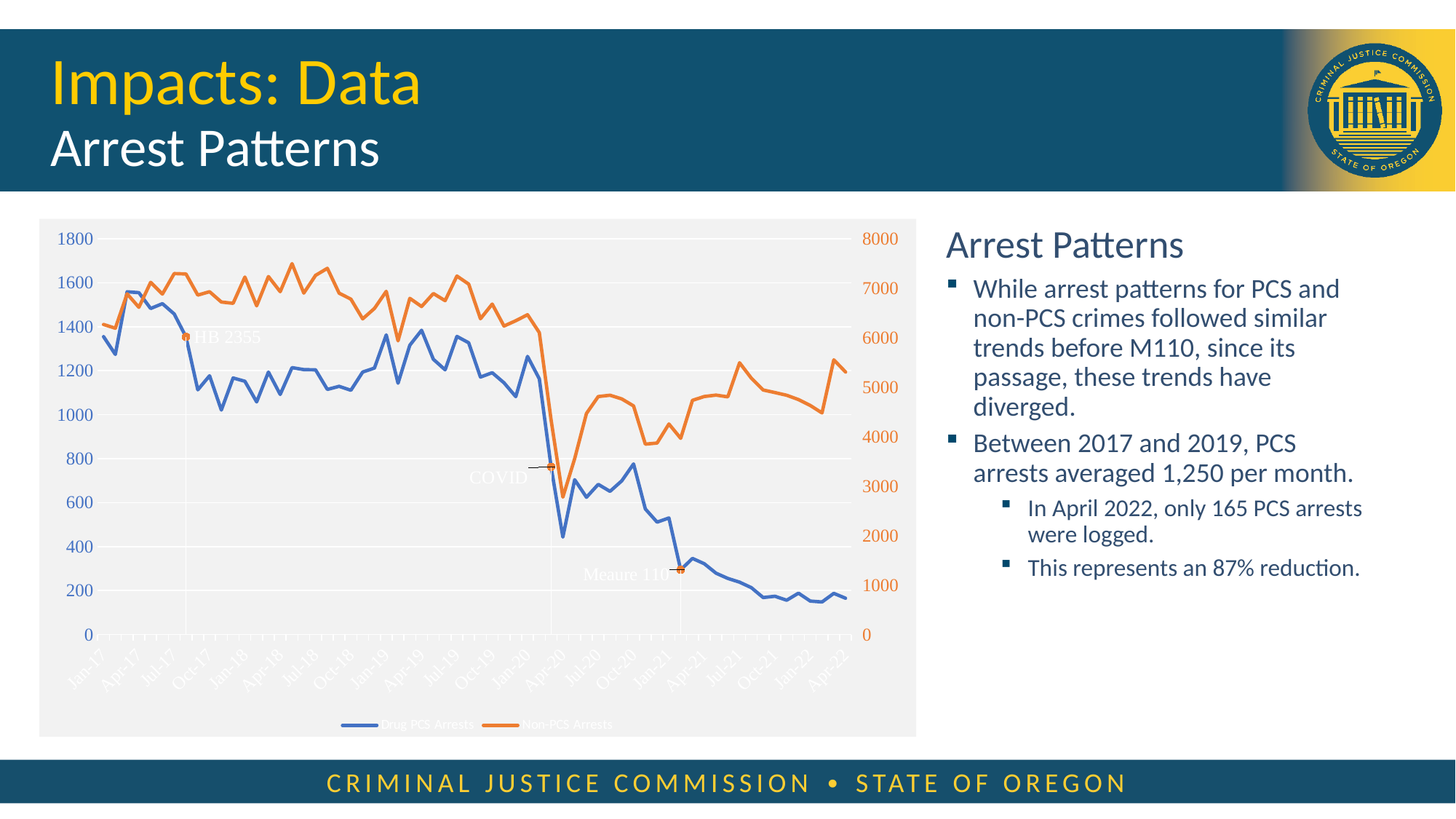
Is the value for Drug PCS Arrests in Apr-22 greater or less than 400? less How many date labels are shown along the x axis? 22 Do Drug PCS Arrests rise or fall between Jan-20 and Apr-22? fall Is the value for Non-PCS Arrests in Apr-18 greater or less than 6000? greater Is the value for Drug PCS Arrests in Jan-17 greater or less than 1000? greater How many series does the chart's legend list? 2 Which event annotation is placed on the chart near Apr-20? COVID What kind of chart is shown on the slide? line chart Which is larger for Drug PCS Arrests: the value in Jan-17 or the value in Apr-22? Jan-17 Which series is plotted against the right-hand axis that runs from 0 to 8000? Non-PCS Arrests Do Non-PCS Arrests rise or fall between Apr-20 and Jul-20? rise